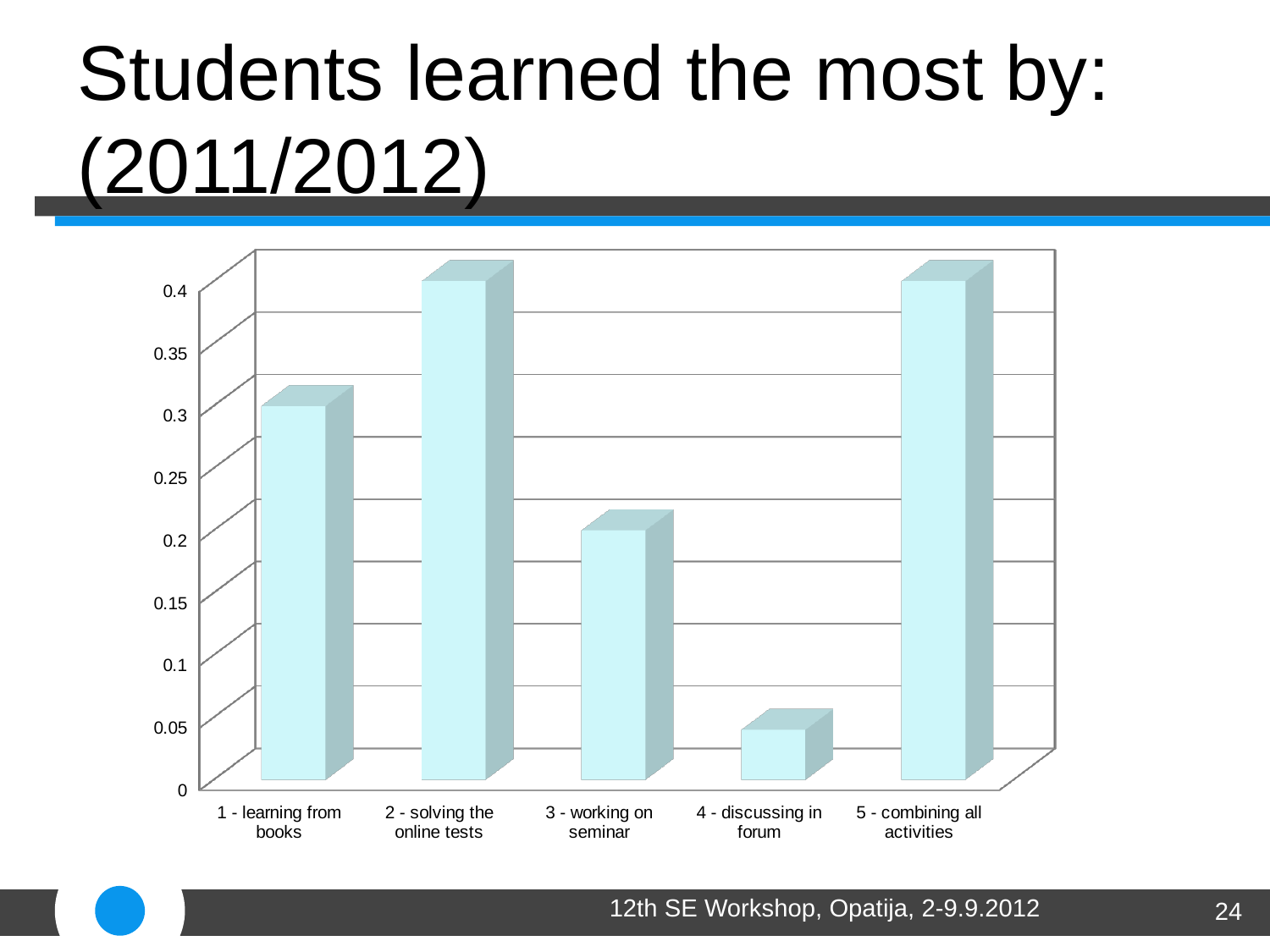
What is the value for '1 - learning from books'? 0.3 What is the difference between the values for '1 - learning from books' and '3 - working on seminar'? 0.1 What is the value for '3 - working on seminar'? 0.2 Is the value for '5 - combining all activities' greater or less than 0.35? greater What is the value for '2 - solving the online tests'? 0.4 Which has a larger value: '1 - learning from books' or '3 - working on seminar'? 1 - learning from books Is the value for '4 - discussing in forum' greater or less than 0.1? less How many categories are shown on the x axis of the chart? 5 Which category has the lowest value in the chart? 4 - discussing in forum What is the title of the slide containing the chart? Students learned the most by: (2011/2012) What kind of chart is shown on the slide? bar chart